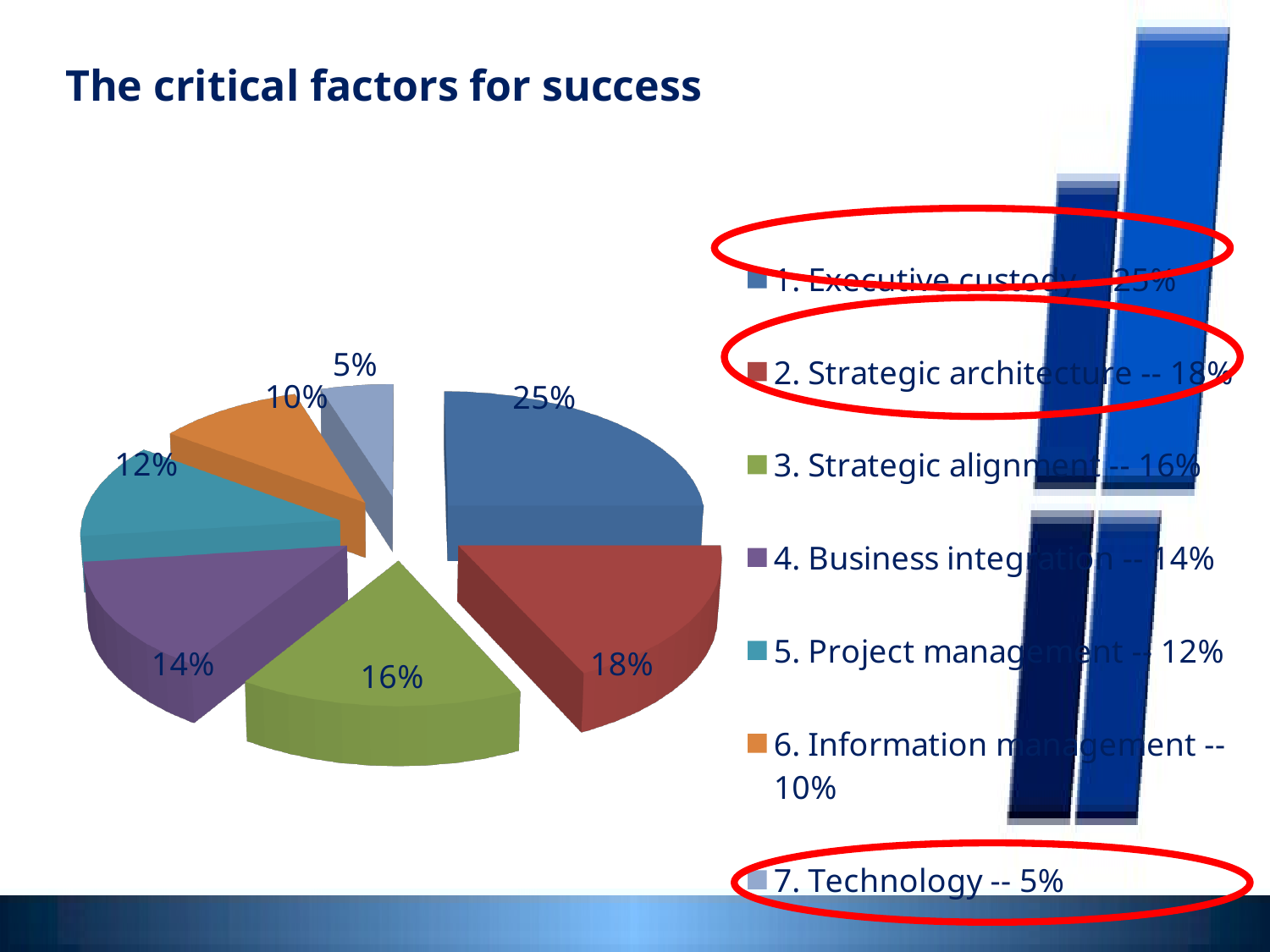
What kind of chart is shown on the slide? Pie chart What percentage is shown for Technology? 5% What percentage is shown for Strategic architecture? 18% Which is larger, the share for Project management or the share for Information management? Project management Which factor has the smallest share of the pie? 7. Technology Which factor has the largest share of the pie? 1. Executive custody How many entries does the legend list? 7 What percentage is shown for Executive custody? 25% What percentage is shown for Business integration? 14% What is the difference in percentage points between Executive custody and Strategic alignment? 9 What is the title of the slide containing the chart? The critical factors for success How many slices does the pie chart have? 7